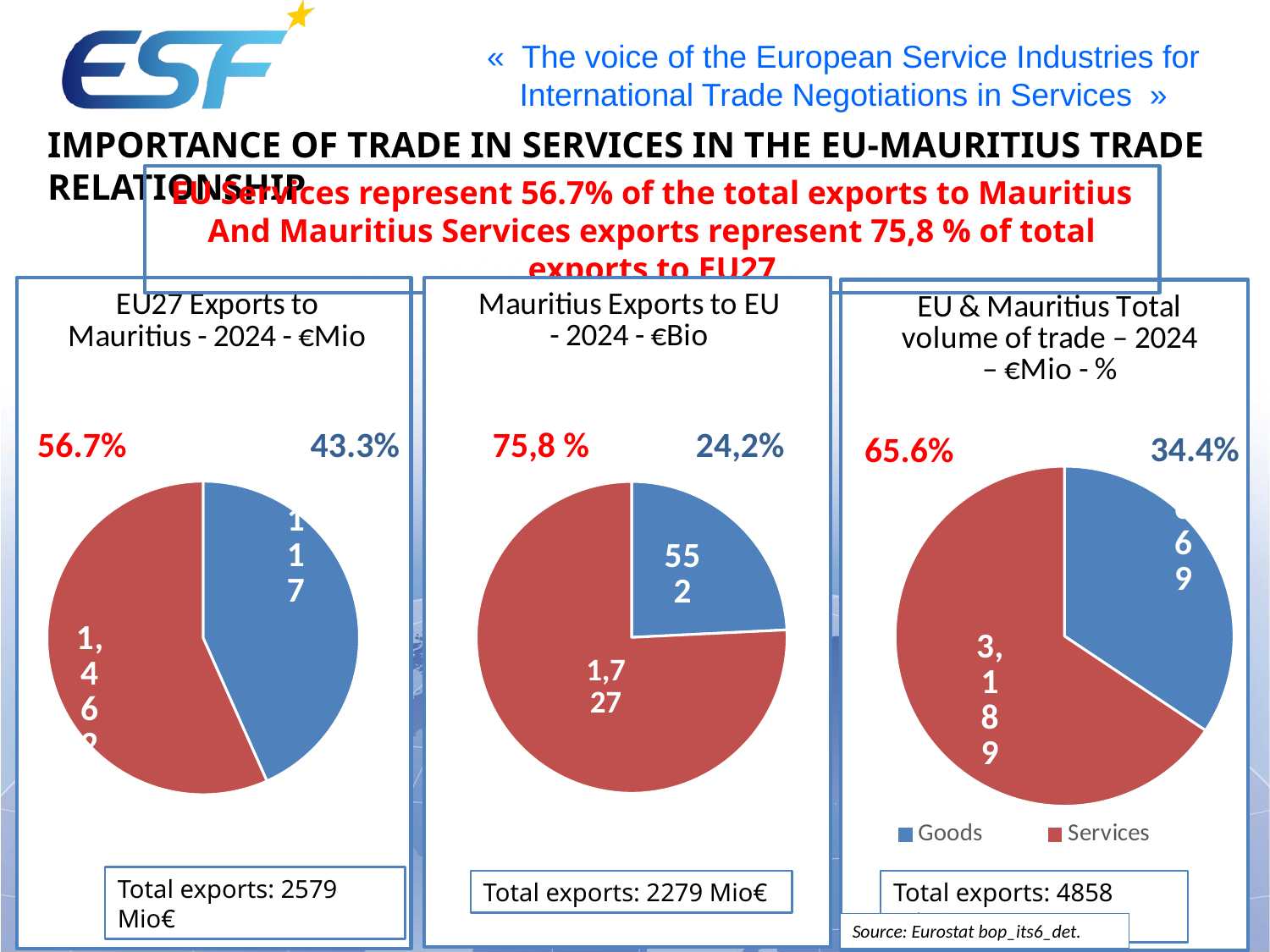
What kind of chart is used for the 'EU27 Exports to Mauritius - 2024' chart? Pie chart In the 'Mauritius Exports to EU - 2024' chart, what is the value for Goods? 552 In the 'EU27 Exports to Mauritius - 2024' chart, what share of the pie is Services? 56.7% In the 'Mauritius Exports to EU - 2024' chart, what is the difference between the Services value and the Goods value? 1,175 How many entries does the legend of the 'EU & Mauritius Total volume of trade – 2024' chart list? 2 In the 'Mauritius Exports to EU - 2024' chart, what is the value for Services? 1,727 In the 'EU & Mauritius Total volume of trade – 2024' chart, what share of the pie is Goods? 34.4% In the 'Mauritius Exports to EU - 2024' chart, what share of the pie is Services? 75,8 % What total exports figure is shown below the 'Mauritius Exports to EU - 2024' chart? 2279 Mio€ In the 'EU27 Exports to Mauritius - 2024' chart, which slice is larger, Goods or Services? Services In the 'EU & Mauritius Total volume of trade – 2024' chart, what is the value for Services? 3,189